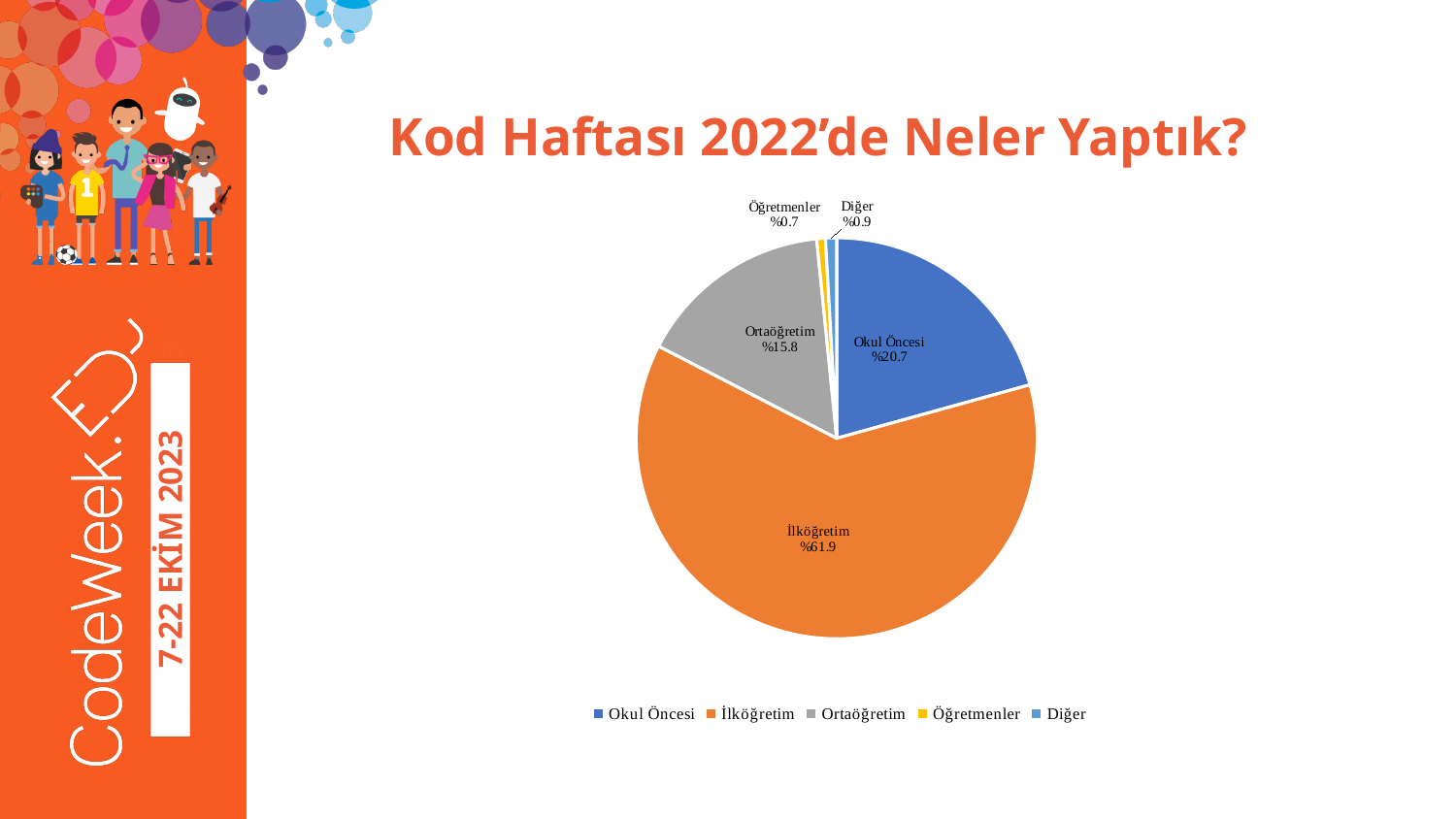
How many categories does the pie chart show? 5 Which category has the smallest slice of the pie? Öğretmenler What share of the pie does Öğretmenler have? %0.7 Which is larger, the share for Okul Öncesi or the share for Ortaöğretim? Okul Öncesi What colour is the İlköğretim slice in the pie chart? Orange What share of the pie does İlköğretim have? %61.9 What share of the pie does Diğer have? %0.9 What share of the pie does Okul Öncesi have? %20.7 What kind of chart is shown on the slide? Pie chart What share of the pie does Ortaöğretim have? %15.8 Which category has the largest slice of the pie? İlköğretim What is the difference in percentage points between İlköğretim and Okul Öncesi? 41.2